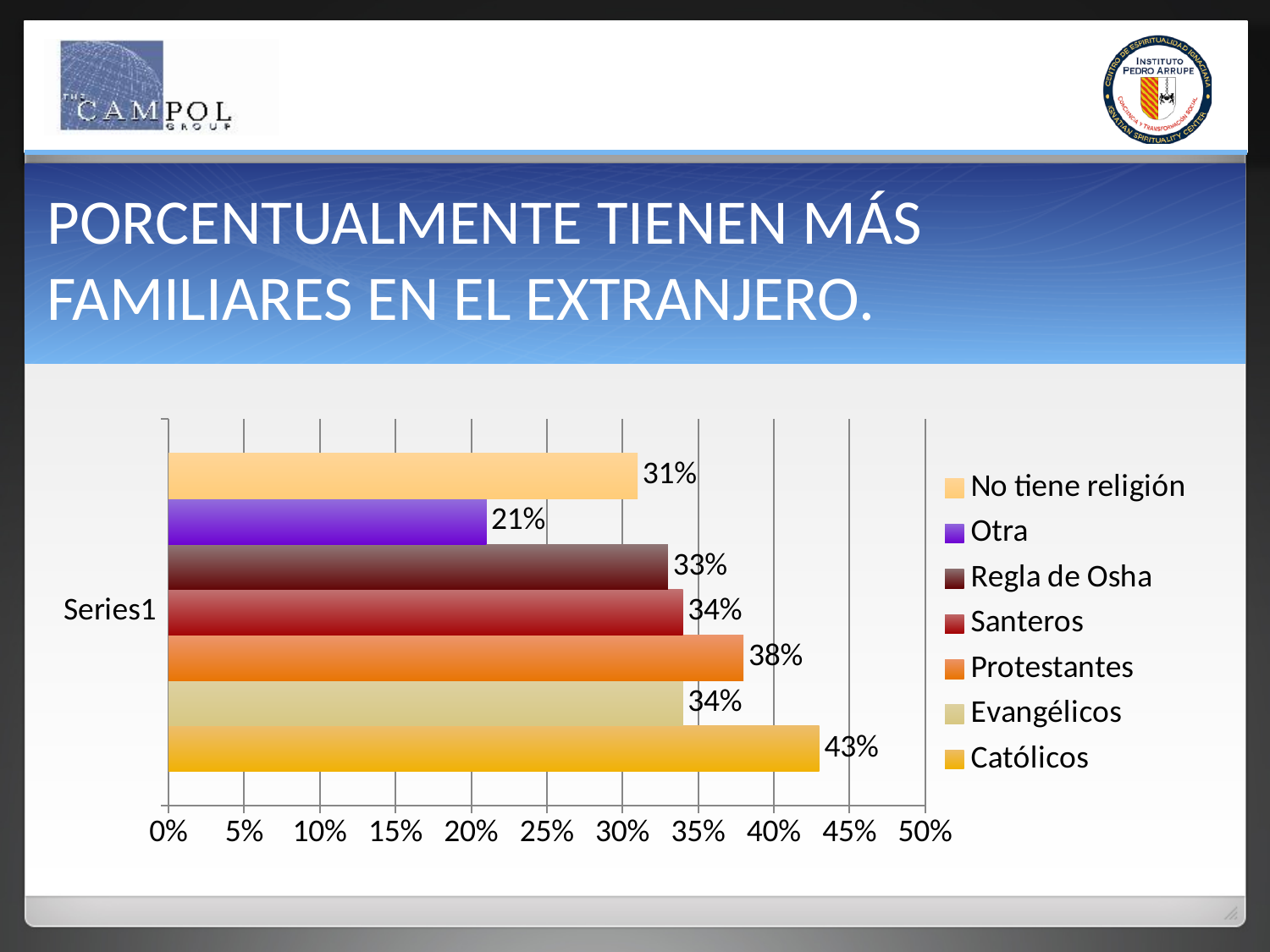
How many series does the legend list? 7 What is the difference between the values for Católicos and Otra? 22% Which group has the lowest value? Otra Which is larger, the value for Protestantes or the value for Santeros? Protestantes What is the value for Otra? 21% What is the value for Protestantes? 38% What is the value for No tiene religión? 31% What is the value for Católicos? 43% Which group has the highest value? Católicos What is the label shown on the vertical axis of the chart? Series1 What kind of chart is shown on the slide? Bar chart What is the difference between the values for Protestantes and Regla de Osha? 5%